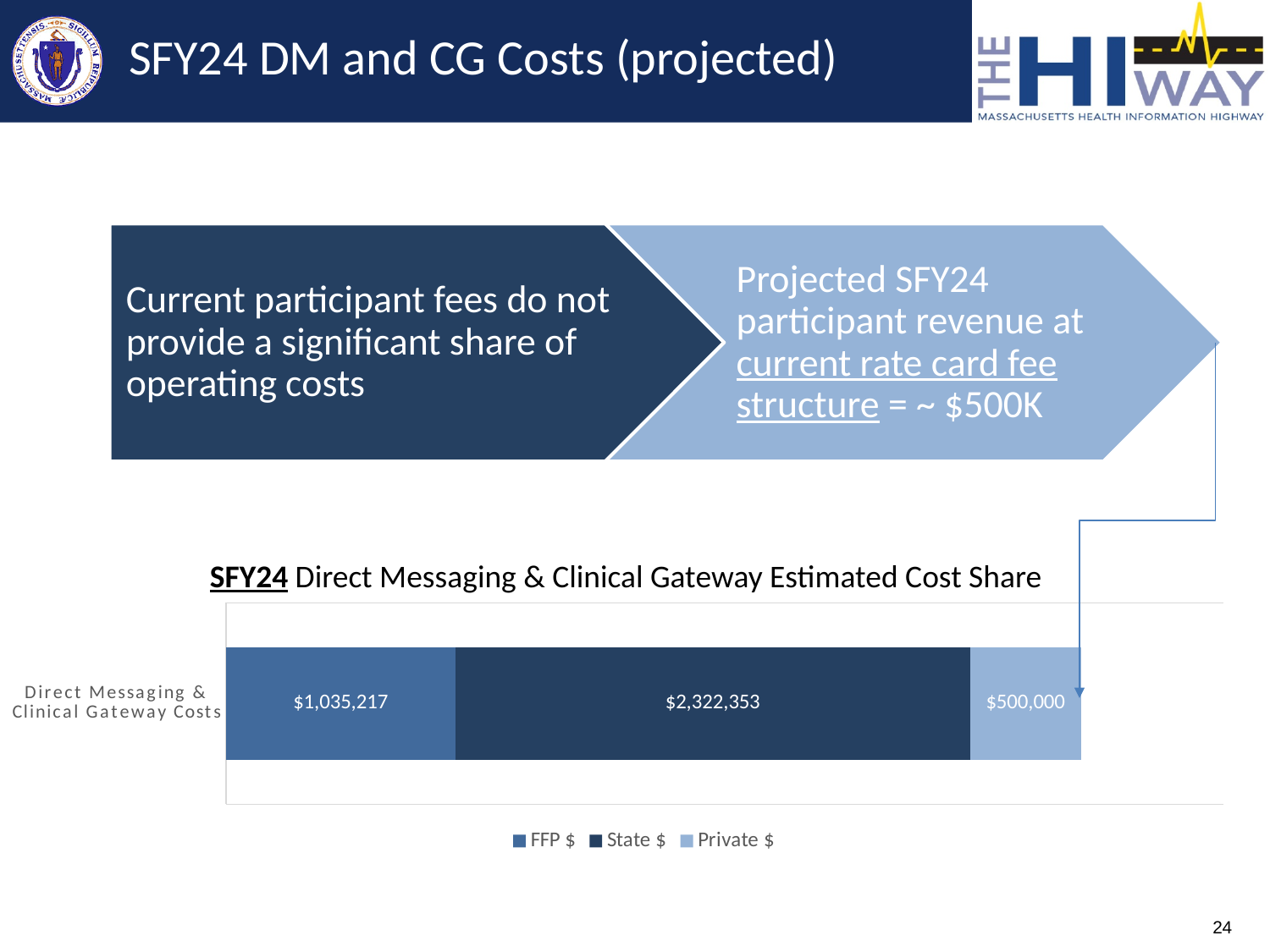
Which is larger, the FFP $ value or the Private $ value? FFP $ What kind of chart is shown on the slide? Stacked bar chart Which series has the smallest segment in the stacked bar? Private $ What is the difference between the FFP $ and Private $ values? $535,217 Which series has the largest segment in the stacked bar? State $ What is the title of the chart on the slide? SFY24 Direct Messaging & Clinical Gateway Estimated Cost Share How many series does the chart legend list? 3 What is the value of the State $ segment in the SFY24 Direct Messaging & Clinical Gateway Estimated Cost Share chart? $2,322,353 What is the total of the stacked bar for Direct Messaging & Clinical Gateway Costs? $3,857,570 What is the value of the FFP $ segment in the chart? $1,035,217 What is the difference between the State $ and FFP $ values? $1,287,136 What is the value of the Private $ segment in the chart? $500,000